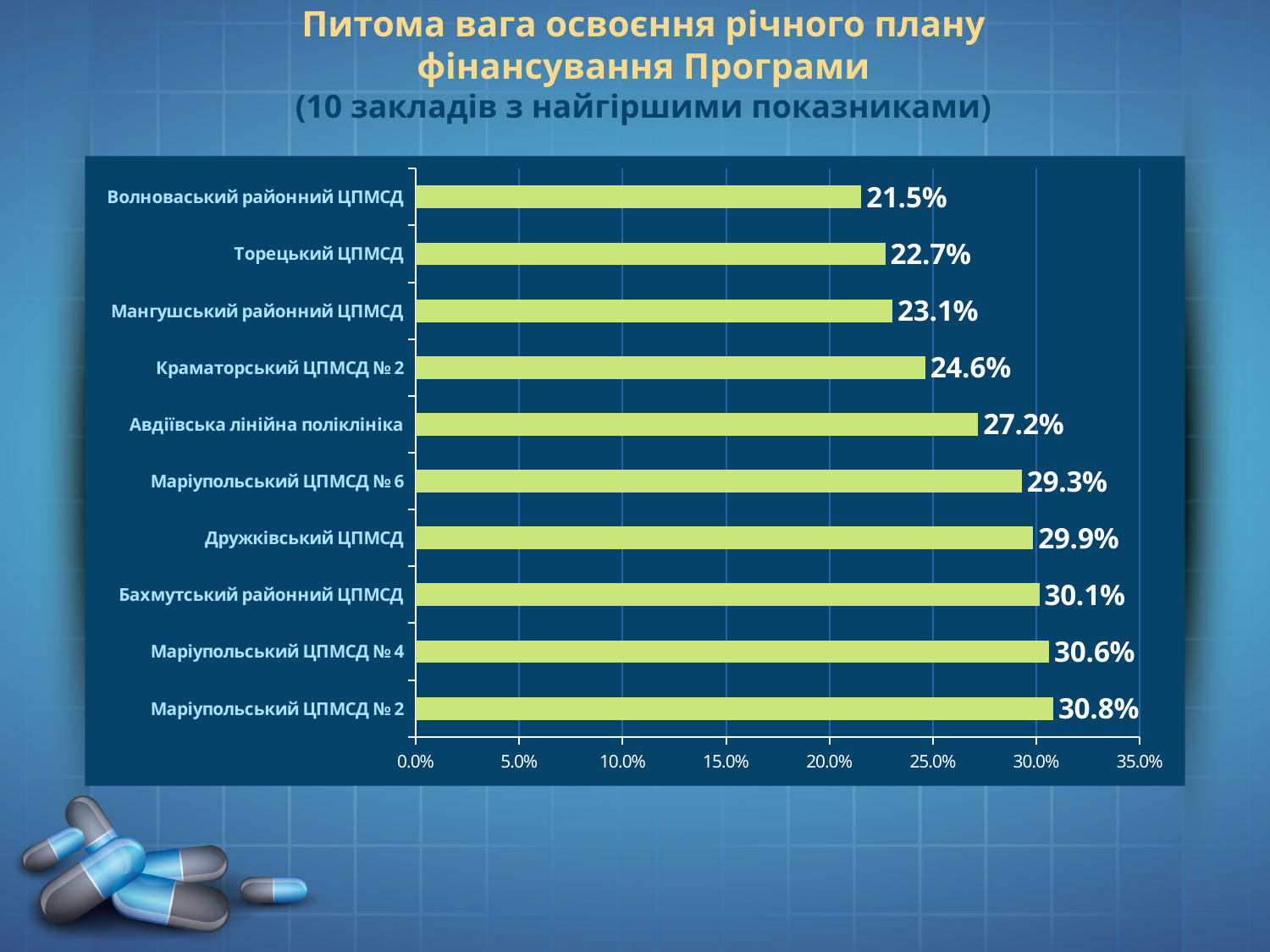
Which category has the highest value? Маріупольський ЦПМСД № 2 Which is larger, the value for Дружківський ЦПМСД or the value for Мангушський районний ЦПМСД? Дружківський ЦПМСД What is the difference between the values for Краматорський ЦПМСД № 2 and Торецький ЦПМСД? 1.9% How many categories are shown in the chart? 10 What kind of chart is shown on the slide? bar chart Which category has the lowest value? Волноваський районний ЦПМСД What is the maximum value shown on the horizontal axis? 35.0% Is the value for Маріупольський ЦПМСД № 6 greater or less than 25.0%? greater What is the value for Волноваський районний ЦПМСД? 21.5% What is the value for Авдіївська лінійна поліклініка? 27.2% What is the value for Маріупольський ЦПМСД № 4? 30.6% What is the difference between the values for Маріупольський ЦПМСД № 2 and Волноваський районний ЦПМСД? 9.3%